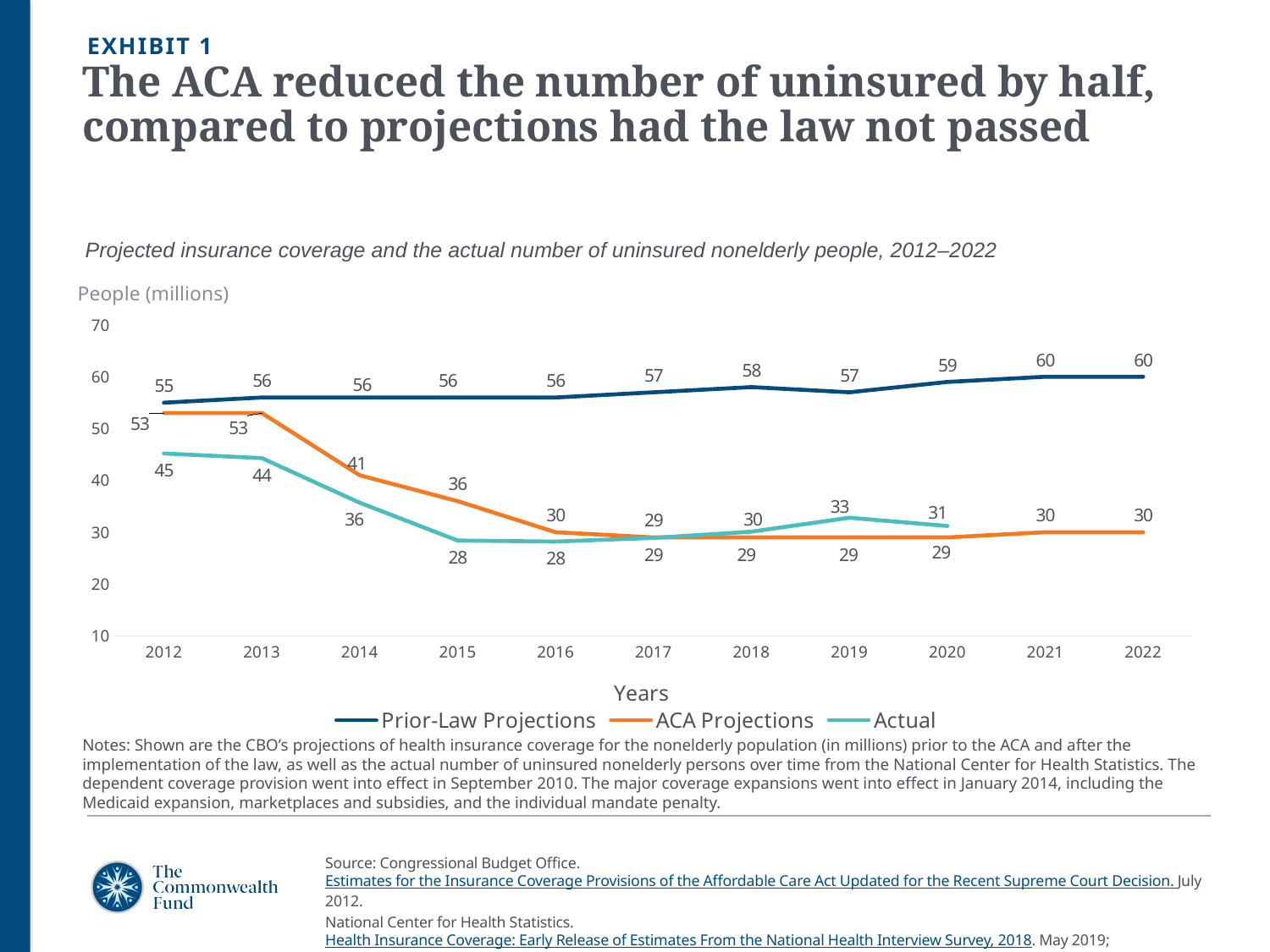
How many years are shown on the x axis? 11 How many series does the legend list? 3 In 2014, which is larger: the Actual value or the ACA Projections value? ACA Projections Do the Prior-Law Projections values generally rise or fall from 2012 to 2022? Rise What is the ACA Projections value for 2014? 41 What is the Actual value for 2019? 33 In which year is the Actual series at its highest? 2012 What is the label on the y axis of the chart? People (millions) By how much did the Actual value fall from 2012 to 2015? 17 What is the Prior-Law Projections value for 2022? 60 What is the difference between the Prior-Law Projections and ACA Projections values in 2022? 30 What kind of chart is shown on the slide? Line chart